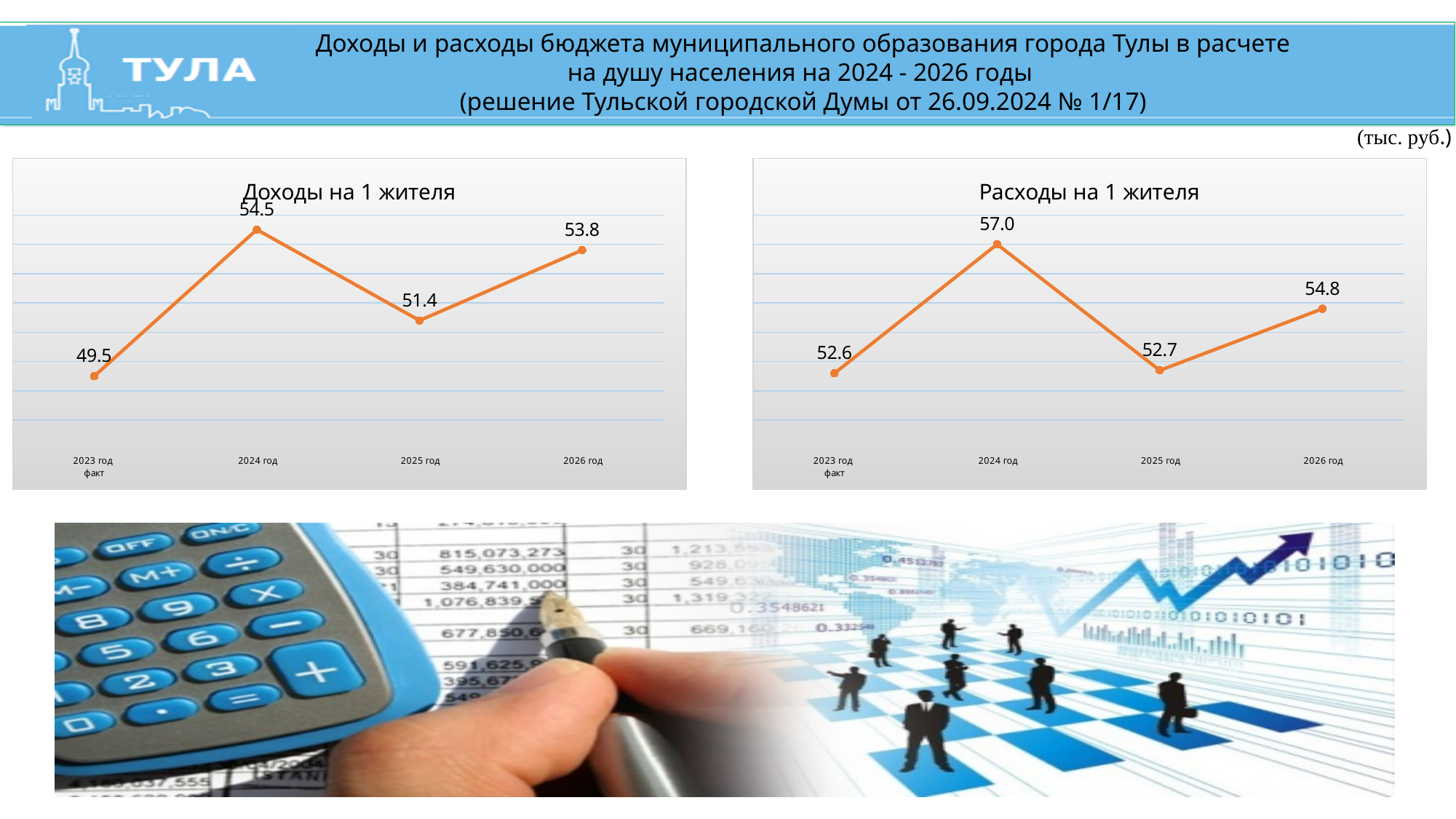
What unit is stated for the values on the slide? тыс. руб. In the chart 'Расходы на 1 жителя', what is the value for 2023 год факт? 52.6 How many data points are plotted in the chart 'Доходы на 1 жителя'? 4 In the chart 'Расходы на 1 жителя', what is the difference between the values for 2024 год and 2025 год? 4.3 In the chart 'Расходы на 1 жителя', which is larger: the value for 2023 год факт or the value for 2026 год? 2026 год In the chart 'Доходы на 1 жителя', which is larger: the value for 2025 год or the value for 2026 год? 2026 год In the chart 'Расходы на 1 жителя', which year has the highest value? 2024 год In the chart 'Доходы на 1 жителя', what is the difference between the values for 2024 год and 2023 год факт? 5.0 In the chart 'Доходы на 1 жителя', does the value rise or fall from 2024 год to 2025 год? Fall In the chart 'Доходы на 1 жителя', which year has the lowest value? 2023 год факт In the chart 'Доходы на 1 жителя', what is the value for 2024 год? 54.5 What kind of chart is 'Расходы на 1 жителя'? Line chart